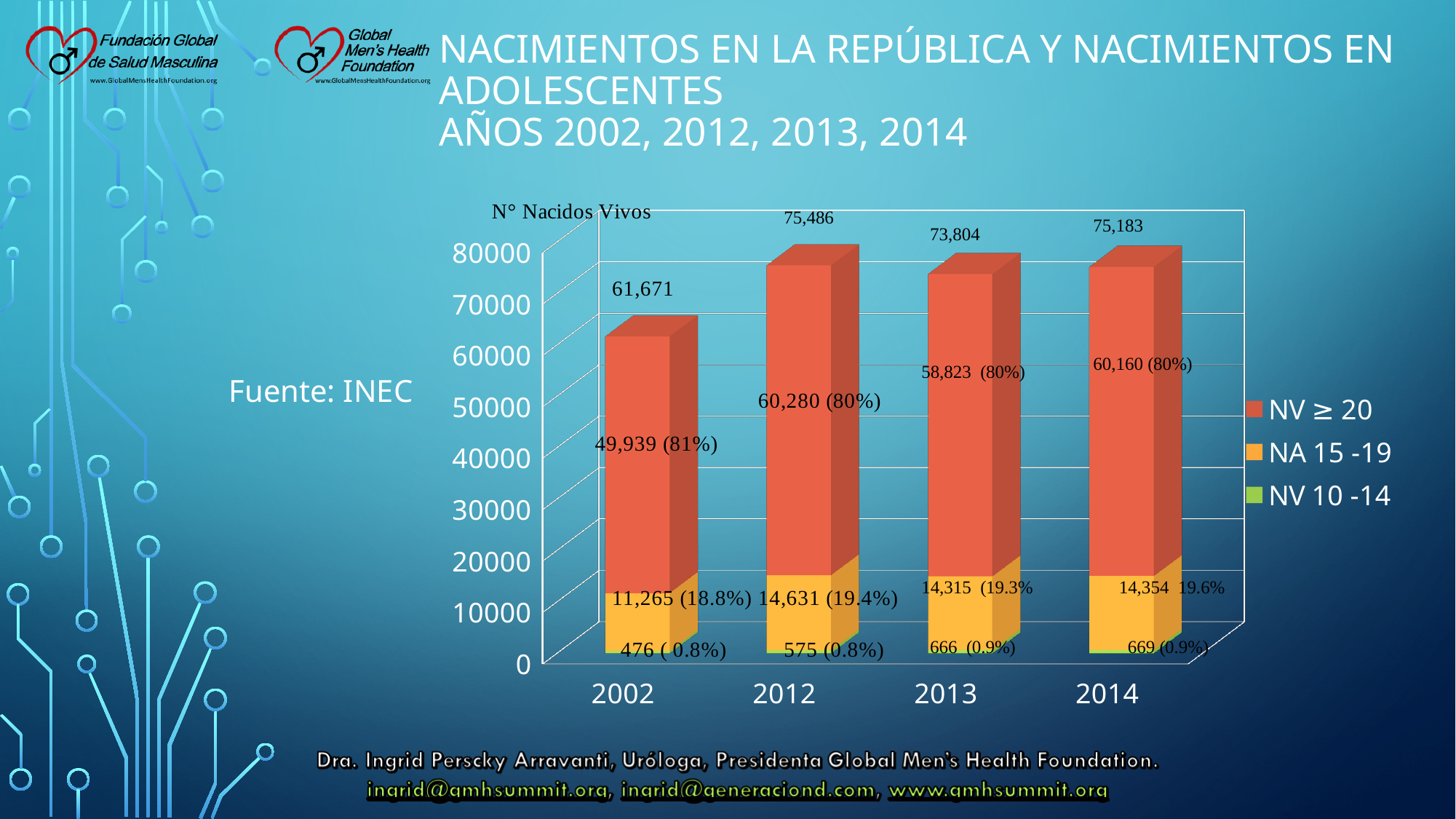
What is the difference between the NV ≥ 20 values for 2012 and 2002? 10,341 What is the value for NA 15 -19 in 2002? 11,265 How many series does the legend list? 3 What is the value for NV ≥ 20 in 2013? 58,823 Which year has the highest total number of live births? 2012 What type of chart is shown on the slide? Stacked bar chart What percentage share does NA 15 -19 represent in 2014? 19.6% What is the total number of live births shown for 2012? 75,486 How many years (categories) are shown on the x axis? 4 Which is larger, the NA 15 -19 value for 2012 or for 2013? 2012 Which year has the lowest total number of live births? 2002 What is the value for NV 10 -14 in 2014? 669